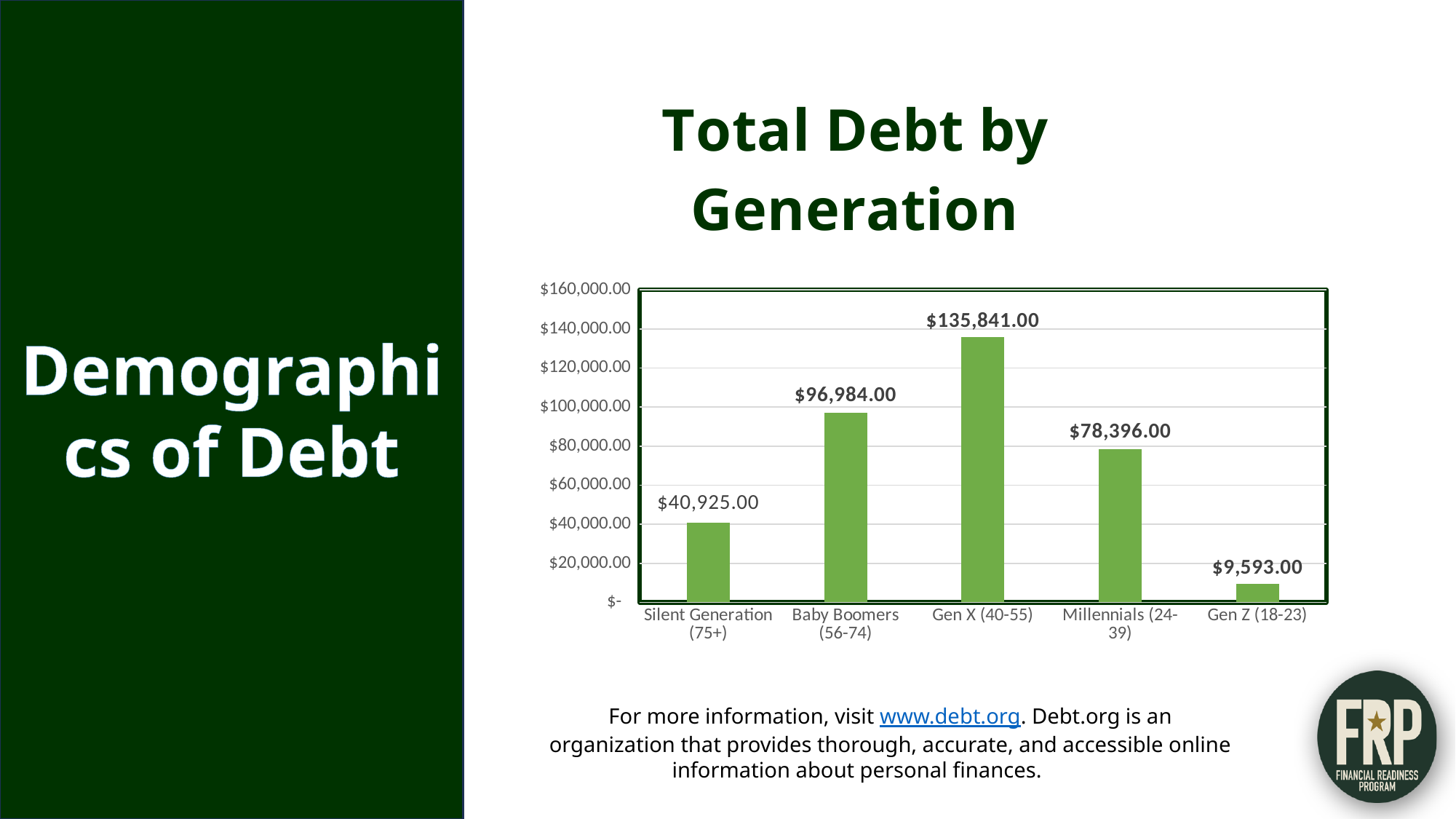
What is the total debt for Millennials (24-39)? $78,396.00 What type of chart is used to show total debt by generation? Bar chart What is the total debt for Gen X (40-55)? $135,841.00 What is the total debt for Gen Z (18-23)? $9,593.00 Which generation has the highest total debt? Gen X (40-55) How many generations are shown in the chart? 5 Which generation has the lowest total debt? Gen Z (18-23) Which has a higher total debt, Baby Boomers (56-74) or Millennials (24-39)? Baby Boomers (56-74) What is the difference in total debt between Millennials (24-39) and Gen Z (18-23)? $68,803.00 What is the total debt for the Silent Generation (75+)? $40,925.00 Is the total debt for Baby Boomers (56-74) greater or less than $80,000.00? greater What is the difference in total debt between Gen X (40-55) and Baby Boomers (56-74)? $38,857.00